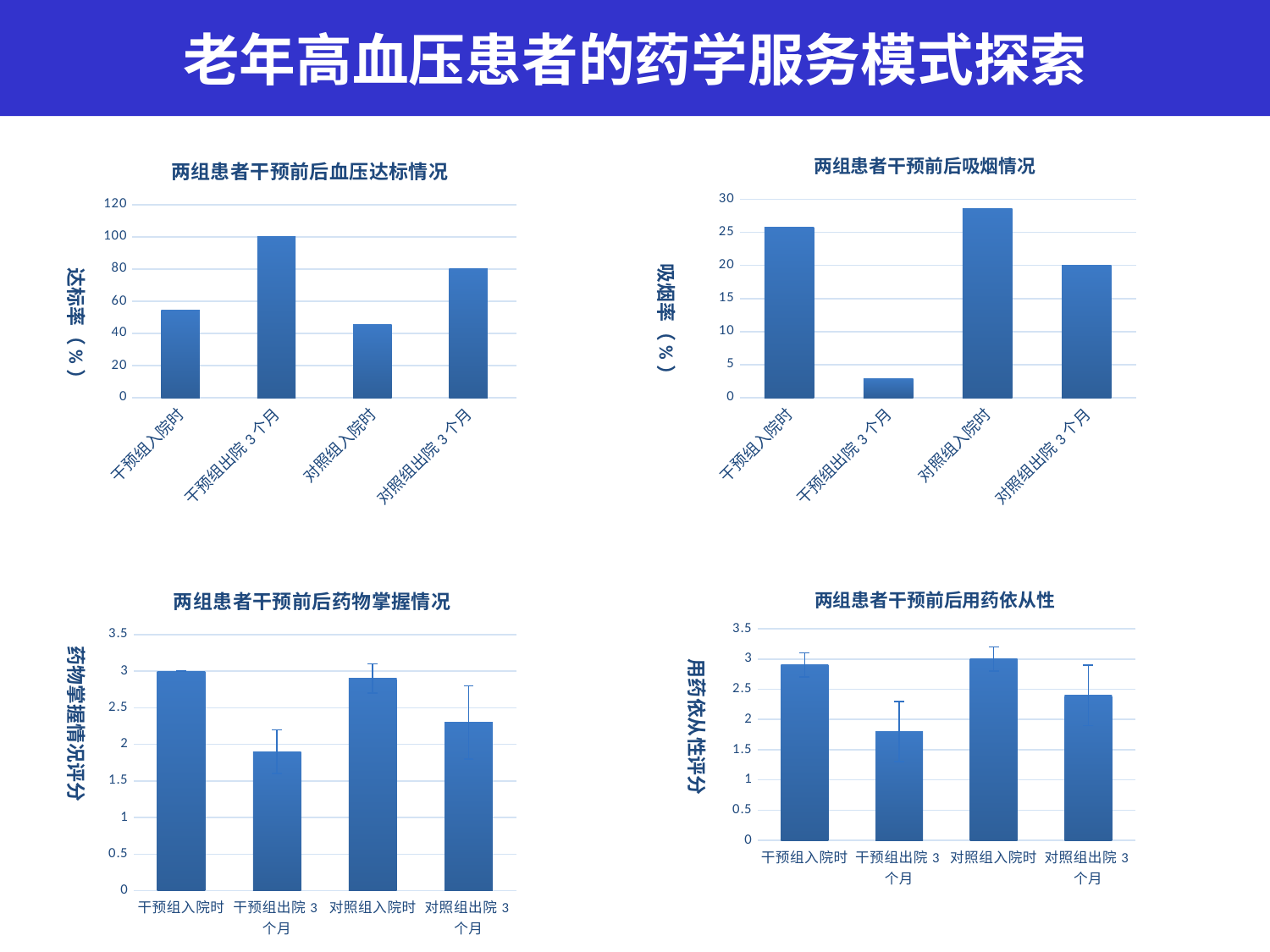
In the chart 两组患者干预前后血压达标情况, is the value for 对照组入院时 greater or less than 60? less In the chart 两组患者干预前后血压达标情况, what is the value for 对照组出院 3 个月? 80 In the chart 两组患者干预前后用药依从性, what is the value for 对照组入院时? 3 In the chart 两组患者干预前后血压达标情况, what is the value for 干预组出院 3 个月? 100 In the chart 两组患者干预前后药物掌握情况, which is larger, the value for 干预组入院时 or the value for 干预组出院 3 个月? 干预组入院时 In the chart 两组患者干预前后吸烟情况, which category has the lowest value? 干预组出院 3 个月 In the chart 两组患者干预前后吸烟情况, what is the value for 对照组出院 3 个月? 20 In the chart 两组患者干预前后血压达标情况, how many categories are shown? 4 In the chart 两组患者干预前后吸烟情况, is the value for 干预组入院时 greater or less than 20? greater What is the y-axis label of the chart 两组患者干预前后用药依从性? 用药依从性评分 What kind of chart is 两组患者干预前后血压达标情况? bar chart In the chart 两组患者干预前后血压达标情况, which category has the highest value? 干预组出院 3 个月